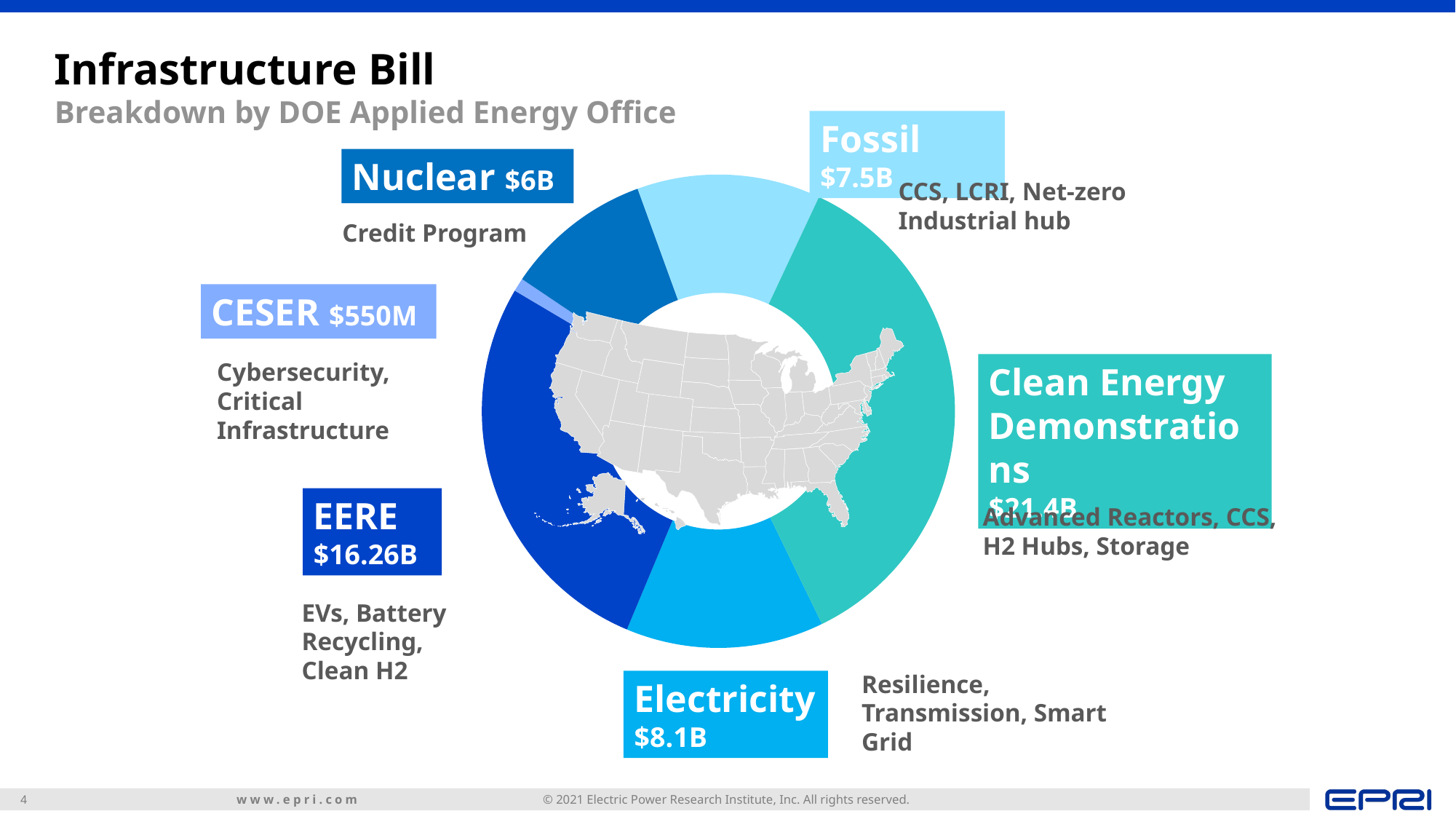
What kind of chart is shown on the slide? Donut (pie) chart What is the value shown for Nuclear? $6B Which office has the smallest share of the donut chart? CESER How many offices are shown as segments in the chart? 6 What is the value shown for Electricity? $8.1B What is the value shown for EERE? $16.26B What is the value shown for Fossil? $7.5B What image is shown in the center of the donut chart? A map of the United States What is the value shown for CESER? $550M Which office has the largest share of the donut chart? Clean Energy Demonstrations Which is larger, the value for EERE or the value for Fossil? EERE What is the difference between the Fossil value and the Nuclear value? $1.5B